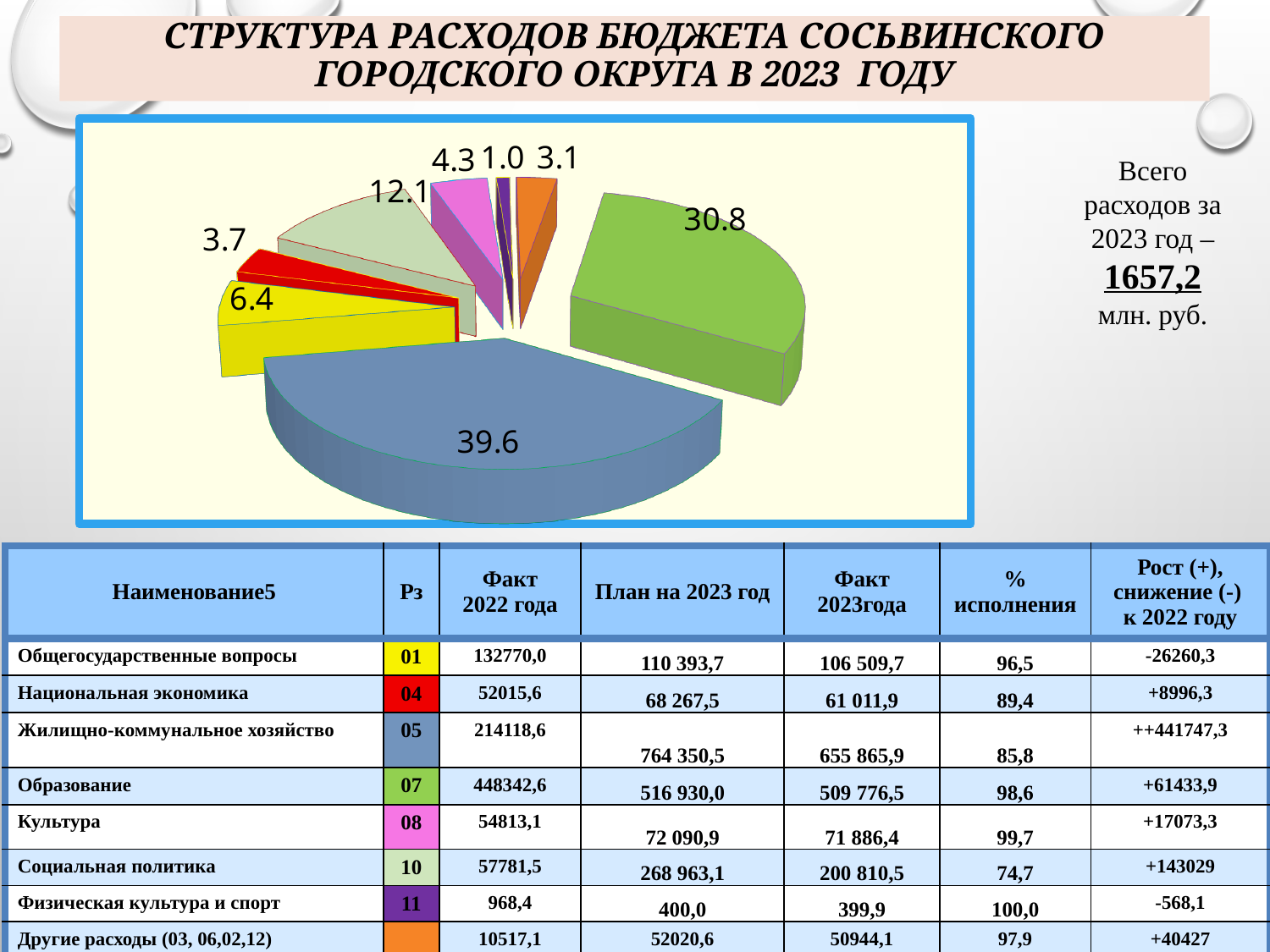
What is the difference between the largest slice (39.6) and the second largest slice (30.8) in the pie chart? 8.8 What value is shown on the red slice of the pie chart? 3.7 What value is shown on the yellow slice of the pie chart? 6.4 What value is shown on the pink slice of the pie chart? 4.3 What is the value of the smallest slice of the pie chart? 1.0 Which slice is larger in the pie chart: the light green slice (12.1) or the yellow slice (6.4)? the light green slice (12.1) How many slices does the pie chart have? 8 What value is shown on the green slice of the pie chart? 30.8 Which slice is larger in the pie chart: the orange slice or the purple slice? the orange slice (3.1) What is the value of the largest slice of the pie chart? 39.6 What is the title of the slide containing the pie chart? Структура расходов бюджета Сосьвинского городского округа в 2023 году What kind of chart is shown on the slide? pie chart